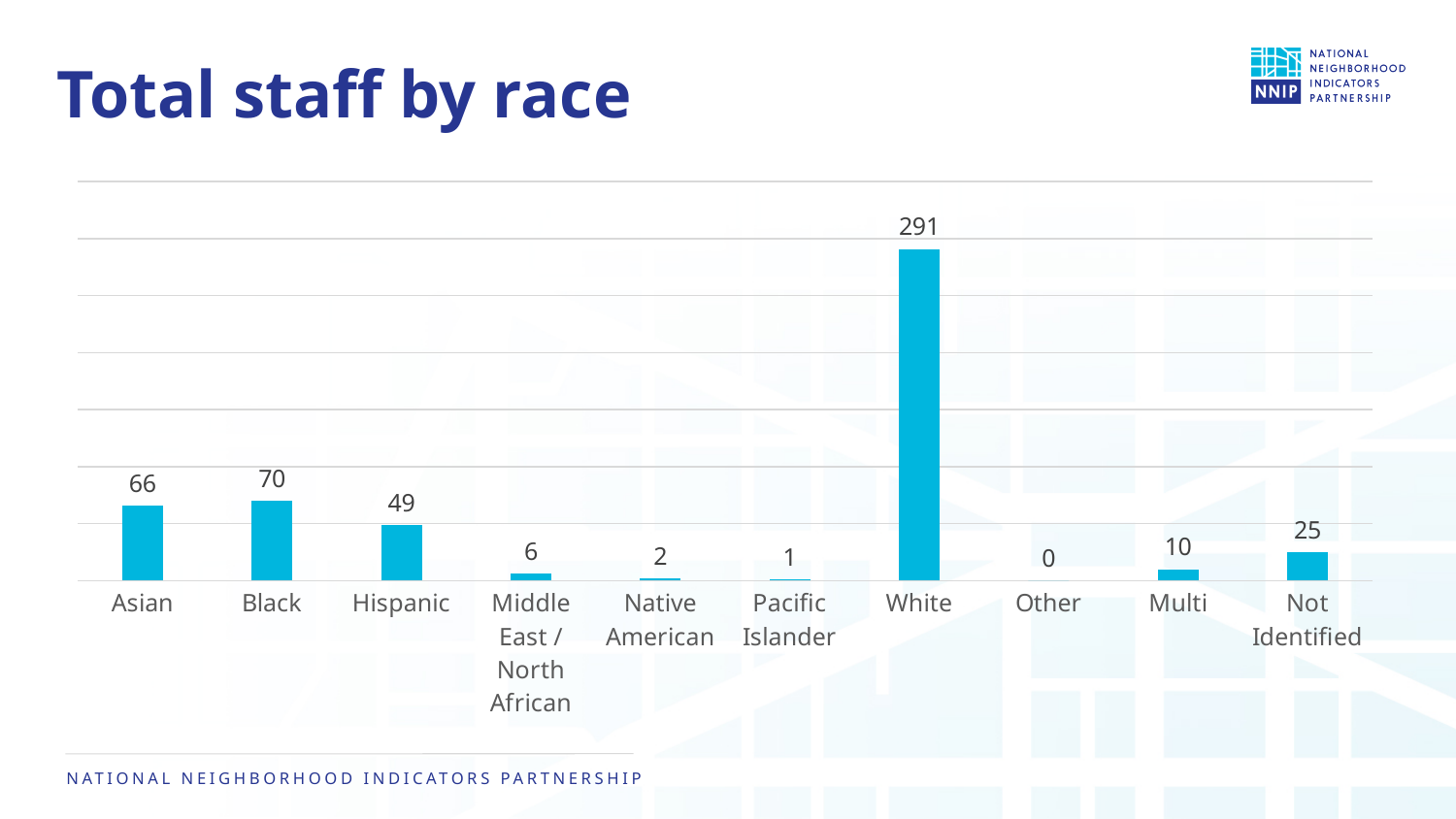
Which race category has the highest total staff? White What is the total staff count for Not Identified? 25 What is the total staff count for Middle East / North African? 6 Which has more staff, Native American or Pacific Islander? Native American How many race categories are shown on the chart? 10 Which has more staff, Multi or Not Identified? Not Identified Which race category has the lowest total staff? Other What is the difference between the staff counts for White and Hispanic? 242 What kind of chart is shown on the slide? Bar chart What is the difference between the staff counts for Black and Asian? 4 What is the total staff count for White? 291 What is the total staff count for Hispanic? 49